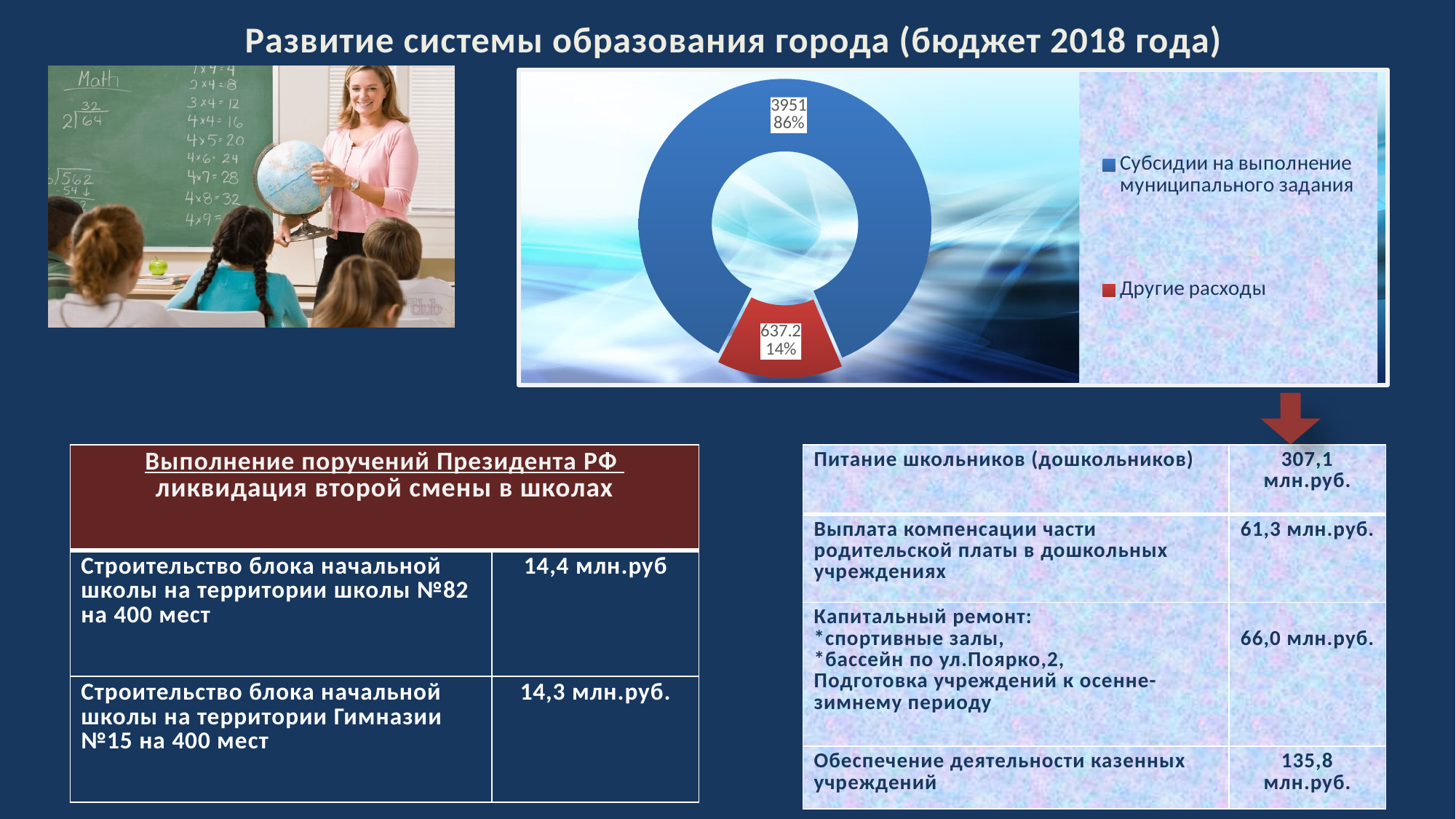
What colour is the slice for "Другие расходы" in the doughnut chart? Red Which category has the smallest slice in the doughnut chart? Другие расходы What value is shown for "Другие расходы" in the doughnut chart? 637.2 What type of chart is shown on the slide? Doughnut chart What percentage share does "Другие расходы" have in the doughnut chart? 14% What value is shown for "Субсидии на выполнение муниципального задания" in the doughnut chart? 3951 What percentage share does "Субсидии на выполнение муниципального задания" have in the doughnut chart? 86% What colour is the slice for "Субсидии на выполнение муниципального задания" in the doughnut chart? Blue How many categories does the doughnut chart show? 2 What is the difference between the values for "Субсидии на выполнение муниципального задания" and "Другие расходы" in the doughnut chart? 3313.8 Which is larger in the doughnut chart: "Субсидии на выполнение муниципального задания" or "Другие расходы"? Субсидии на выполнение муниципального задания Which category has the largest slice in the doughnut chart? Субсидии на выполнение муниципального задания